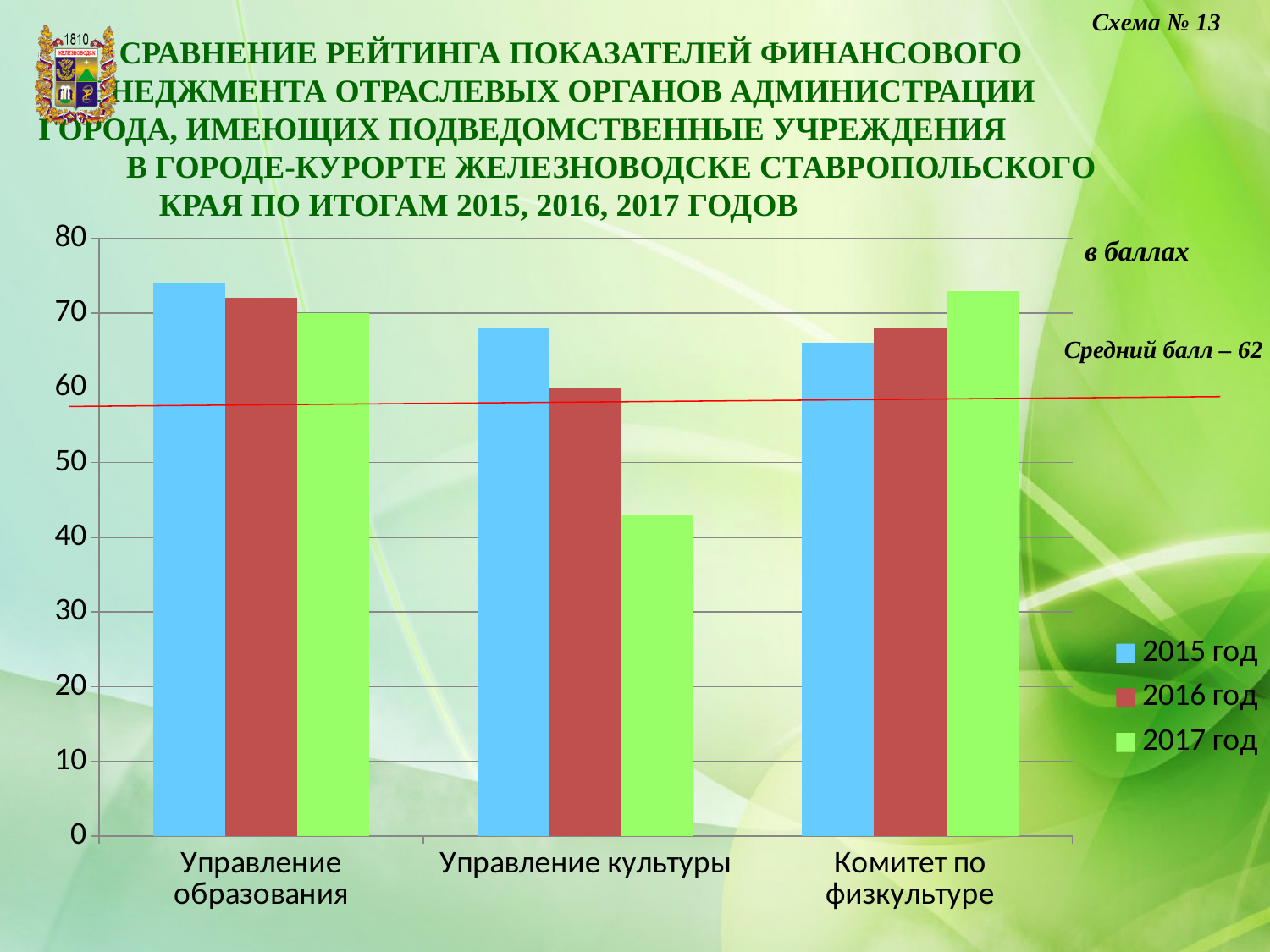
Which category has the highest value for 2015 год? Управление образования Is the value for Комитет по физкультуре in 2017 год greater or less than 70? greater How many categories are shown on the x axis? 3 What kind of chart is shown on the slide? bar chart What average score (Средний балл) is indicated next to the chart? 62 Which category has the lowest value for 2017 год? Управление культуры How many series does the legend list? 3 Is the value for Управление образования in 2015 год greater or less than 70? greater Do the values for Управление культуры rise or fall from 2015 год to 2017 год? fall Is the value for Управление культуры in 2017 год greater or less than 50? less Which is larger for 2017 год: Управление образования or Управление культуры? Управление образования